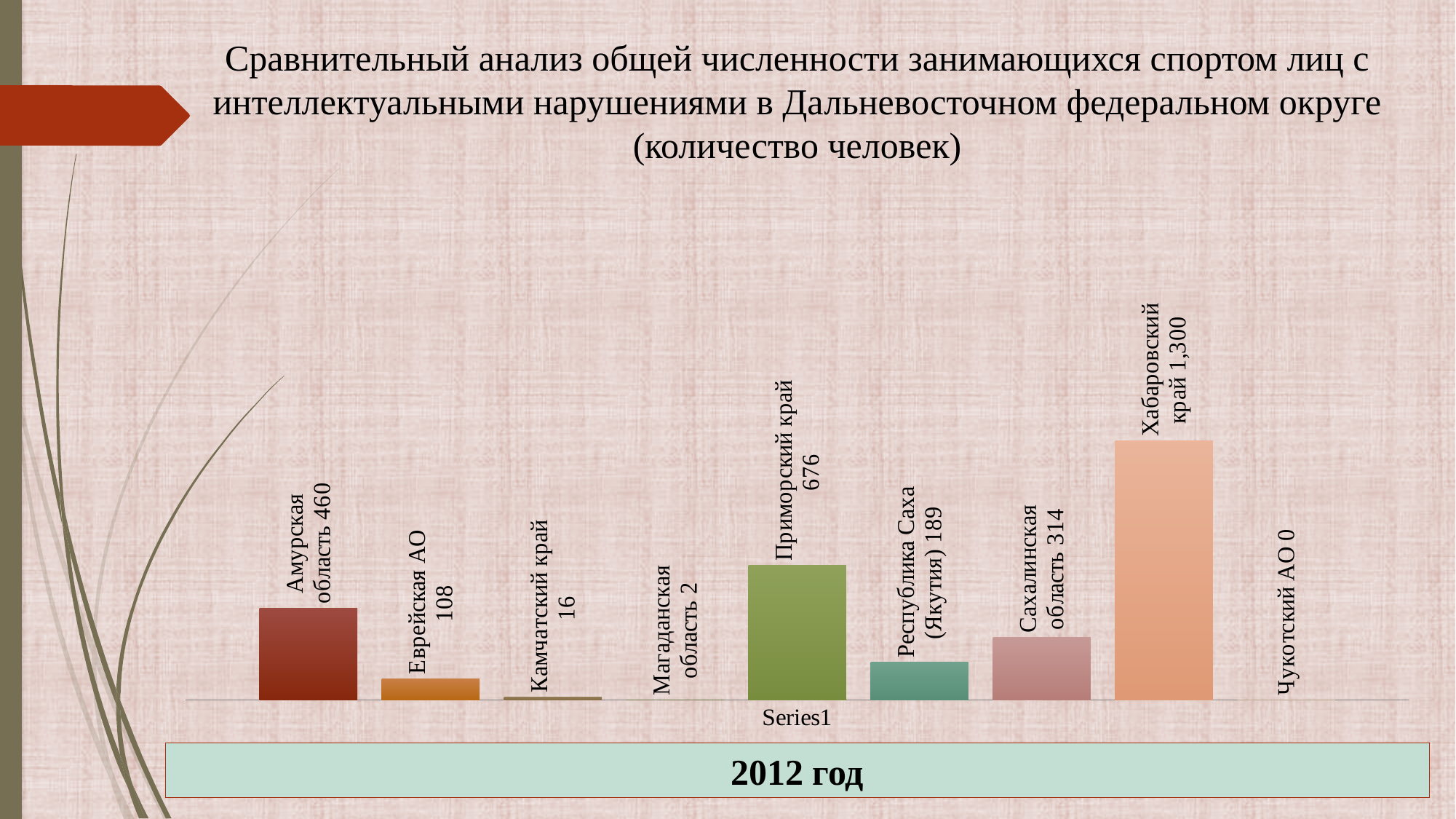
Which region has the highest value? Хабаровский край How many regions are shown in the chart? 9 What is the value for Приморский край? 676 What is the difference between the values for Хабаровский край and Приморский край? 624 What is the value for Магаданская область? 2 Which region has the lowest value? Чукотский АО What is the value for Республика Саха (Якутия)? 189 What kind of chart is shown on the slide? Bar chart Which is larger, the value for Еврейская АО or the value for Республика Саха (Якутия)? Республика Саха (Якутия) Which year does the chart refer to, according to the label below it? 2012 год What is the value for Хабаровский край? 1,300 What is the difference between the values for Амурская область and Сахалинская область? 146